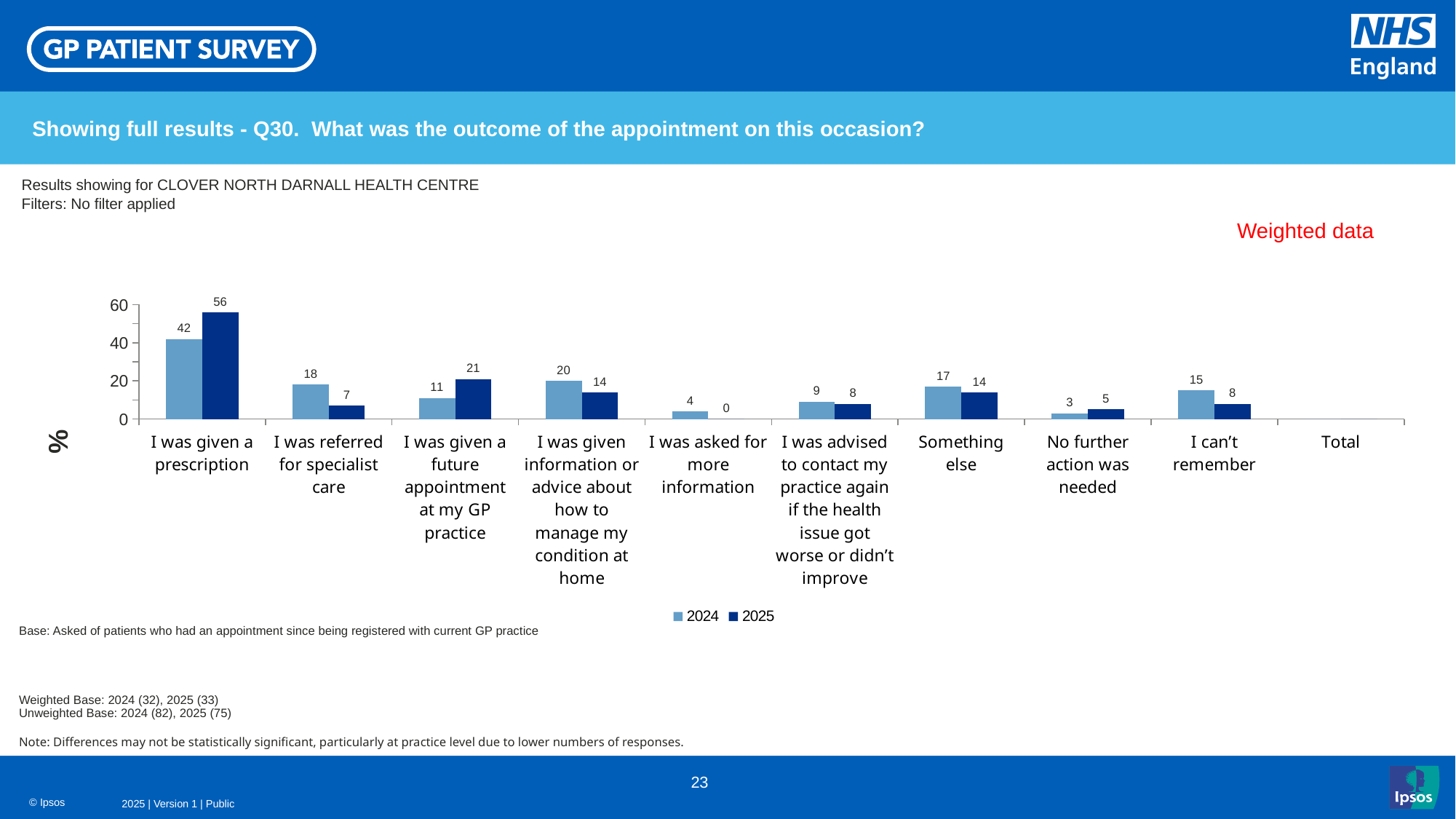
Which category has the highest 2025 value? I was given a prescription What is the 2024 value for "I can't remember"? 15 What is the 2025 value for "I was asked for more information"? 0 Is the 2024 value for "I was given a prescription" greater or less than 40? greater What is the 2024 value for "I was referred for specialist care"? 18 What is the difference between the 2024 and 2025 values for "I was referred for specialist care"? 11 What kind of chart is shown on the slide? Bar chart What is the 2025 value for "I was given a prescription"? 56 Which category has the lowest 2024 value? No further action was needed What is the difference between the 2025 and 2024 values for "I was given a prescription"? 14 How many series does the legend list? 2 Which is larger for "I was given a future appointment at my GP practice": the 2024 value or the 2025 value? 2025